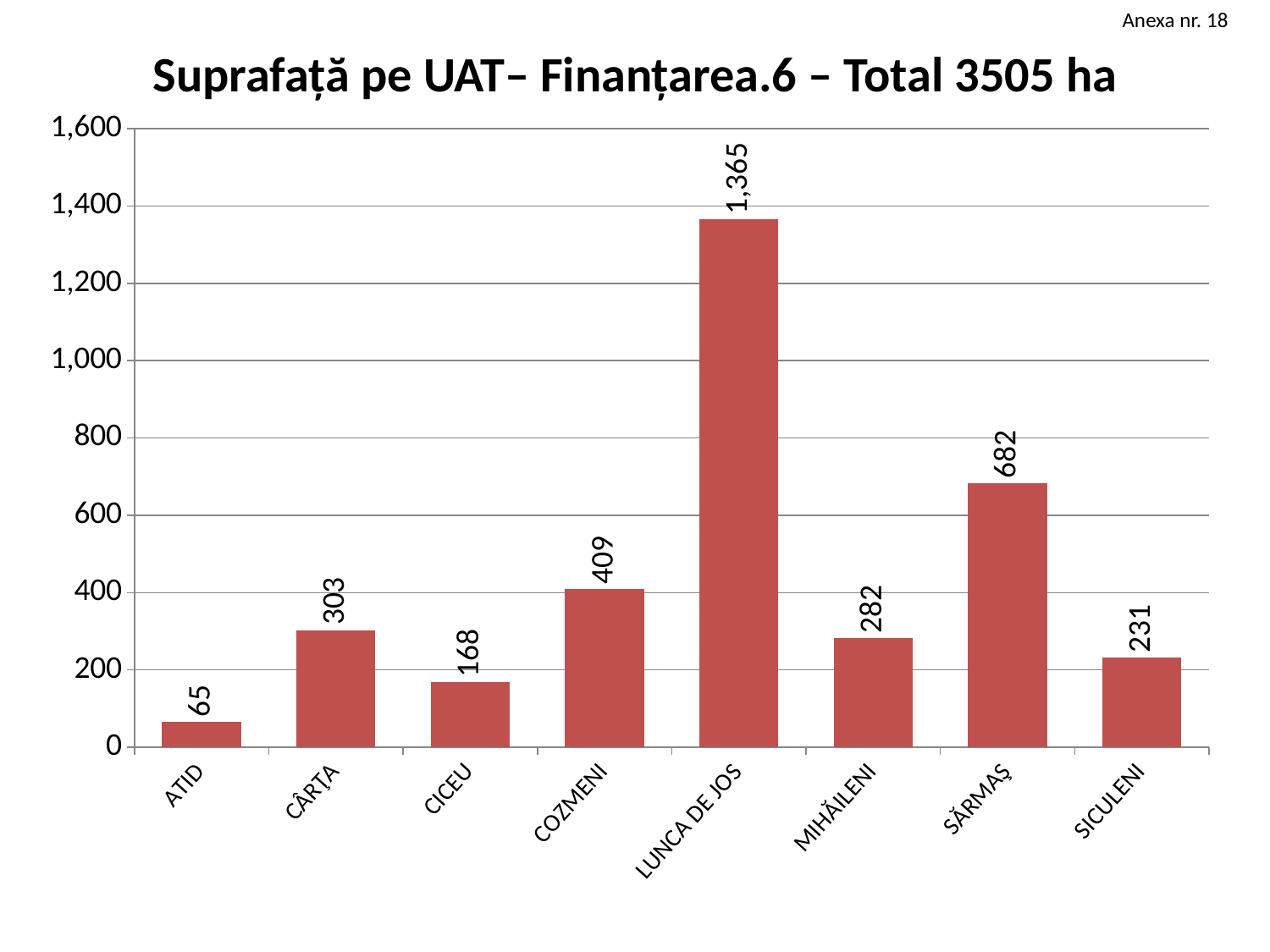
What is the value for CICEU? 168 Which is larger, the value for MIHĂILENI or the value for SICULENI? MIHĂILENI What is the value for SĂRMAŞ? 682 How many categories are shown on the x axis? 8 What is the title of the chart? Suprafață pe UAT– Finanțarea.6 – Total 3505 ha Which category has the highest value? LUNCA DE JOS Is the value for COZMENI greater or less than 400? greater What is the value for LUNCA DE JOS? 1,365 Which category has the lowest value? ATID What is the difference between the values for COZMENI and CÂRŢA? 106 What kind of chart is shown on the slide? bar chart What is the difference between the values for SĂRMAŞ and MIHĂILENI? 400